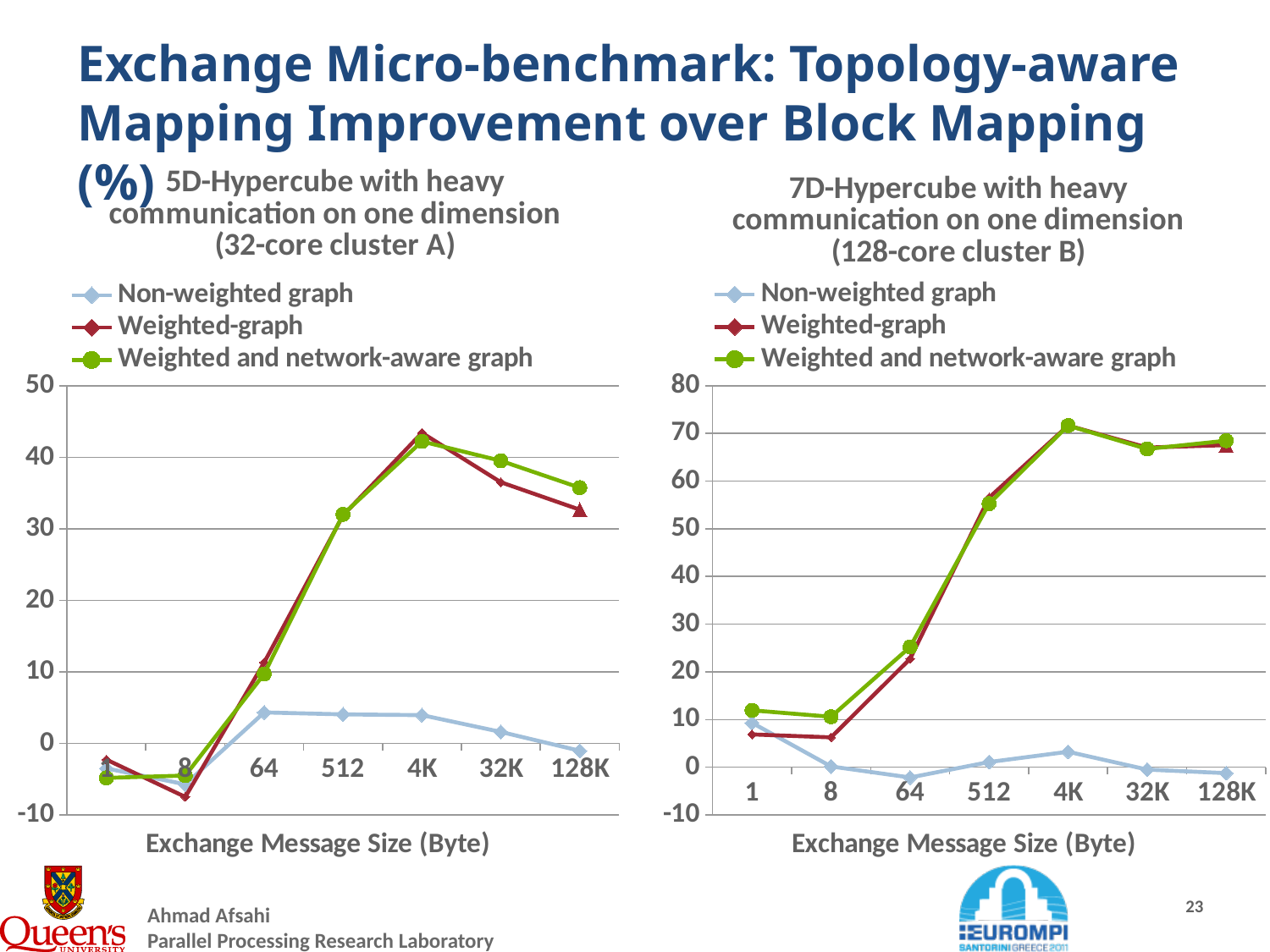
How many message-size categories are shown on the x axis of the left chart (32-core cluster A)? 7 In the left chart (32-core cluster A), at which message size does 'Weighted and network-aware graph' reach its highest value? 4K What kind of chart is the left chart, titled '5D-Hypercube with heavy communication on one dimension (32-core cluster A)'? line chart In the left chart (32-core cluster A), is the value of 'Non-weighted graph' at 4K greater or less than 10? less In the right chart (128-core cluster B), is the value of 'Non-weighted graph' at 64 greater or less than 0? less In the right chart (128-core cluster B), is the value of 'Weighted-graph' at 512 greater or less than 50? greater In the left chart (32-core cluster A), at 128K, which series is higher: 'Weighted-graph' or 'Weighted and network-aware graph'? Weighted and network-aware graph In the right chart (128-core cluster B), does the 'Weighted-graph' series rise or fall from 8 to 4K? rise What is the x-axis title of the right chart (128-core cluster B)? Exchange Message Size (Byte) How many series does the legend of the right chart, '7D-Hypercube with heavy communication on one dimension (128-core cluster B)', list? 3 In the right chart (128-core cluster B), at which message size does 'Non-weighted graph' reach its lowest value? 64